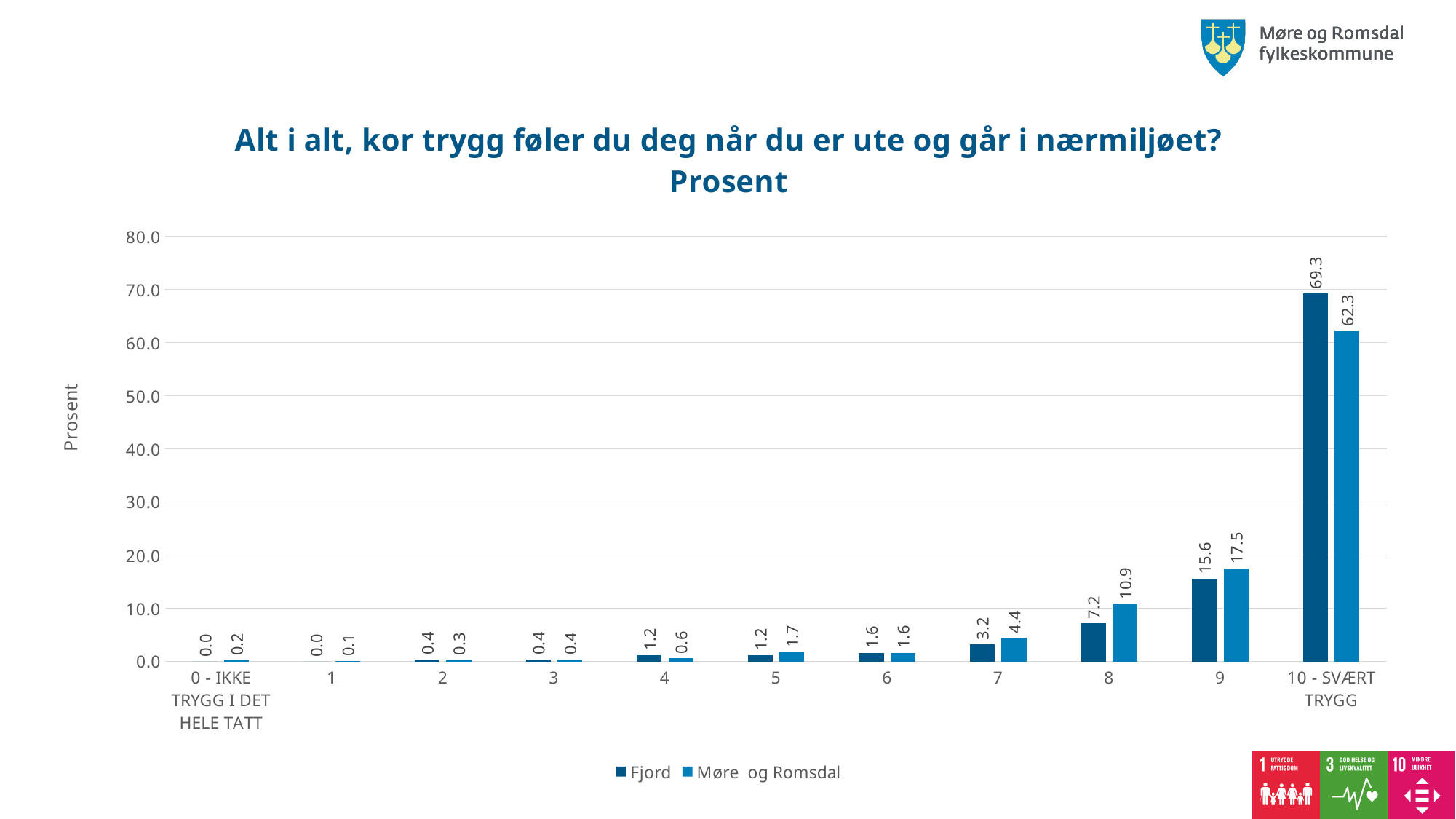
Which is larger at category 9, Fjord or Møre og Romsdal? Møre og Romsdal What is the value for Møre og Romsdal at category 7? 4.4 What is the value for Møre og Romsdal at category 9? 17.5 What is the difference between Fjord and Møre og Romsdal at category 10 - SVÆRT TRYGG? 7.0 What is the difference between Møre og Romsdal and Fjord at category 8? 3.7 What is the value for Fjord at category 8? 7.2 What is the value for Fjord at category 10 - SVÆRT TRYGG? 69.3 How many series does the legend list? 2 How many categories are shown on the x axis? 11 Which category has the highest value for Fjord? 10 - SVÆRT TRYGG Is the value for Fjord at category 10 - SVÆRT TRYGG greater or less than 60.0? greater What kind of chart is shown on the slide? bar chart